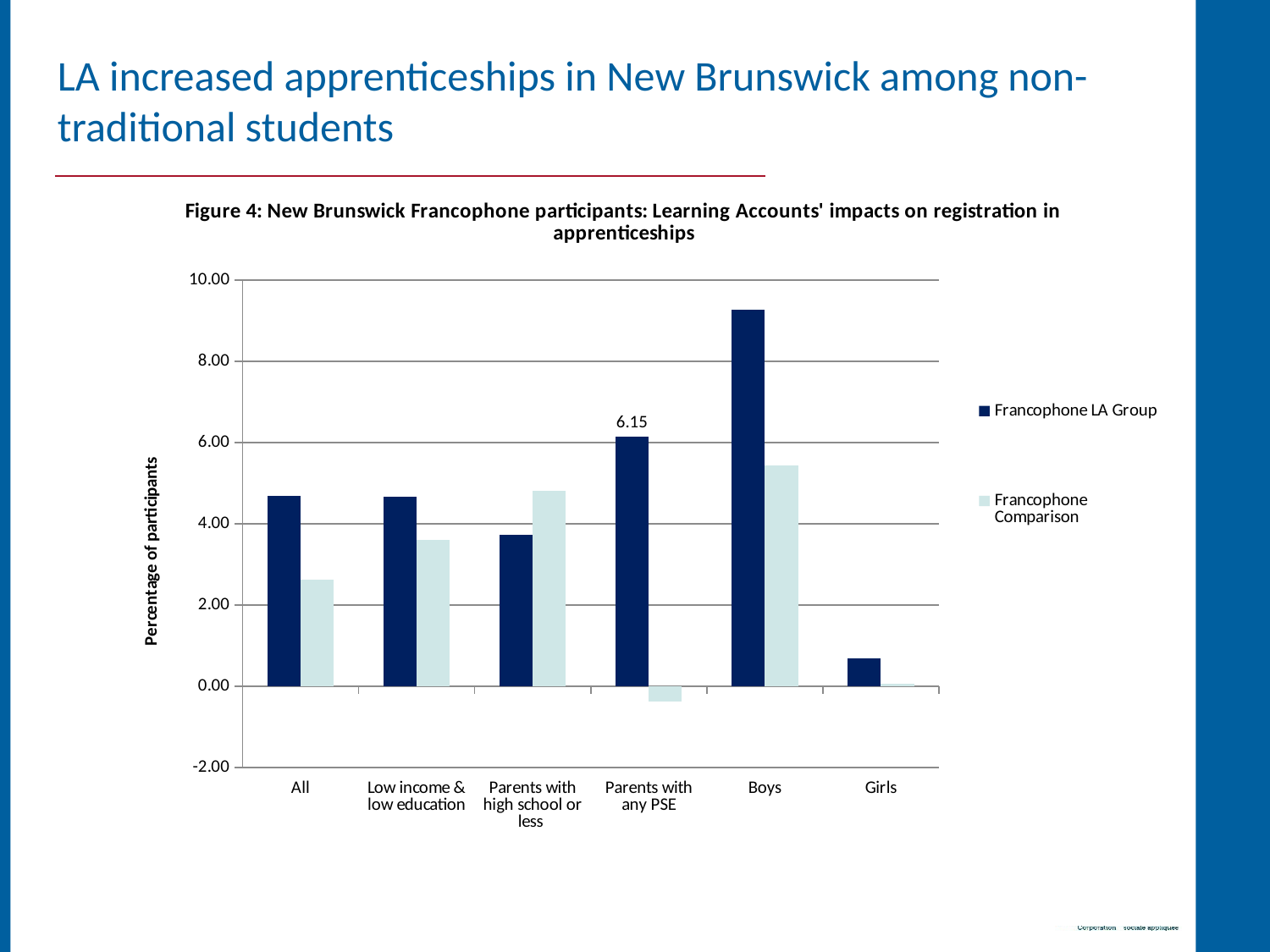
In the 'Parents with high school or less' category, which series has the larger value: Francophone LA Group or Francophone Comparison? Francophone Comparison Which category has the highest value for the Francophone LA Group? Boys In the 'Boys' category, which series has the larger value: Francophone LA Group or Francophone Comparison? Francophone LA Group Is the Francophone LA Group value for Boys greater or less than 8.00? greater How many series does the chart's legend list? 2 What is the value for the Francophone LA Group in the 'Parents with any PSE' category? 6.15 Is the Francophone Comparison value for 'All' greater or less than 4.00? less What kind of chart is shown on the slide? Bar chart How many categories are shown on the x axis of the chart? 6 Which category has the lowest value for the Francophone Comparison series? Parents with any PSE Which category has the lowest value for the Francophone LA Group? Girls Is the Francophone LA Group value for 'Low income & low education' greater or less than 4.00? greater